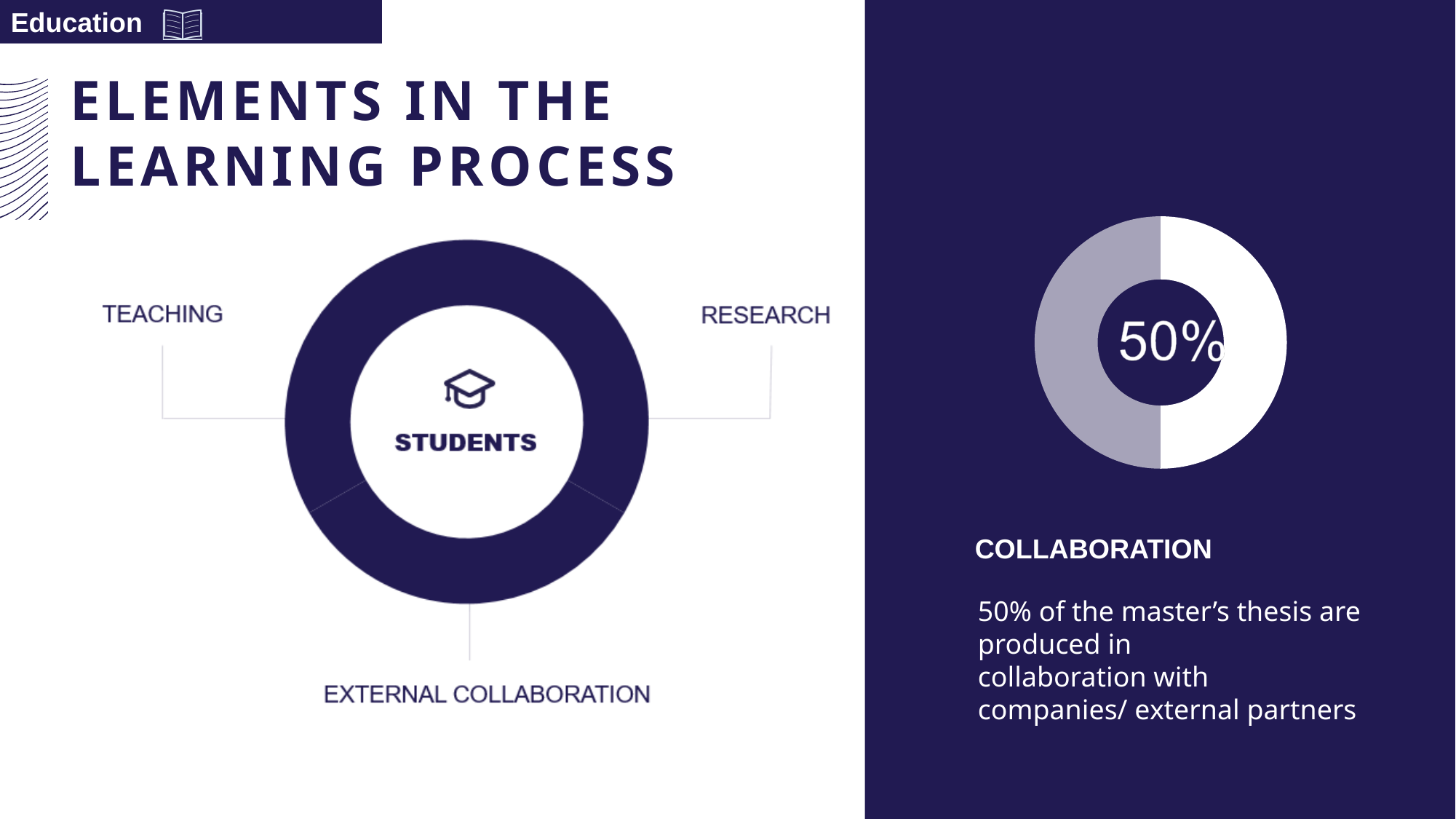
In the ring diagram on the left, what label is in the centre of the ring? STUDENTS How many segments does the donut chart on the right have? 2 What percentage is printed in the centre of the donut chart on the right? 50% According to the text under the donut chart, what percentage of master's theses are produced in collaboration with companies/external partners? 50% In the ring diagram on the left, how many elements are connected around the central 'STUDENTS' circle? 3 What kind of chart is shown on the right-hand side of the slide? Donut chart What heading appears below the donut chart on the right? COLLABORATION What share of the donut chart on the right is filled by the grey segment? 50%